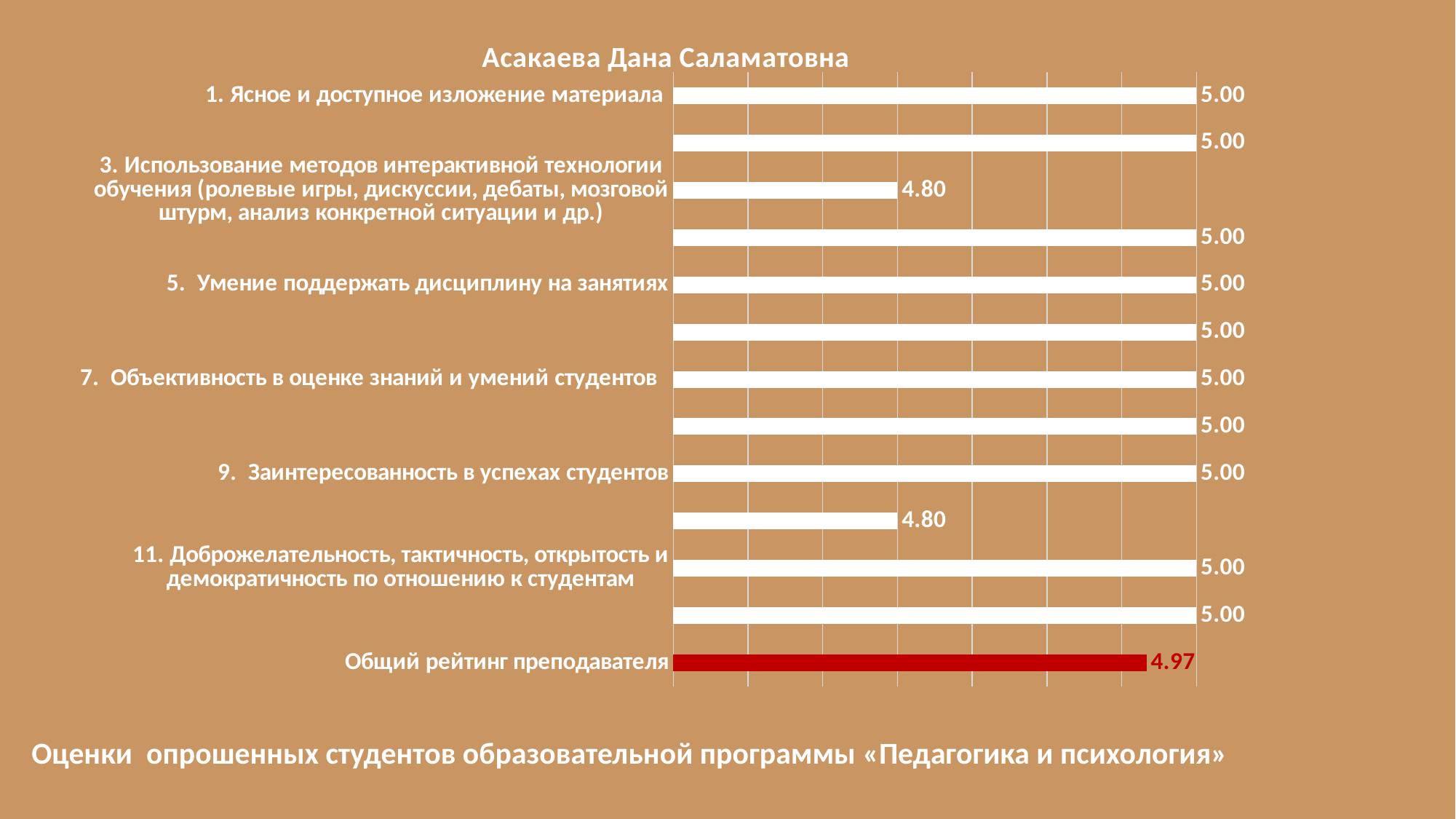
Which has the larger value: "1. Ясное и доступное изложение материала" or "3. Использование методов интерактивной технологии обучения"? 1. Ясное и доступное изложение материала What is the difference between the value for "1. Ясное и доступное изложение материала" and the value for "3. Использование методов интерактивной технологии обучения"? 0.20 What is the difference between the value for "Общий рейтинг преподавателя" and the value for "3. Использование методов интерактивной технологии обучения"? 0.17 What is the value for "11. Доброжелательность, тактичность, открытость и демократичность по отношению к студентам"? 5.00 What is the value for "3. Использование методов интерактивной технологии обучения"? 4.80 What is the value for "1. Ясное и доступное изложение материала"? 5.00 What is the lowest value shown on the chart? 4.80 What is the value for "5. Умение поддержать дисциплину на занятиях"? 5.00 What is the value for "Общий рейтинг преподавателя"? 4.97 What is the title of the chart? Асакаева Дана Саламатовна How many bars are plotted on the chart? 13 What kind of chart is shown on the slide? Bar chart